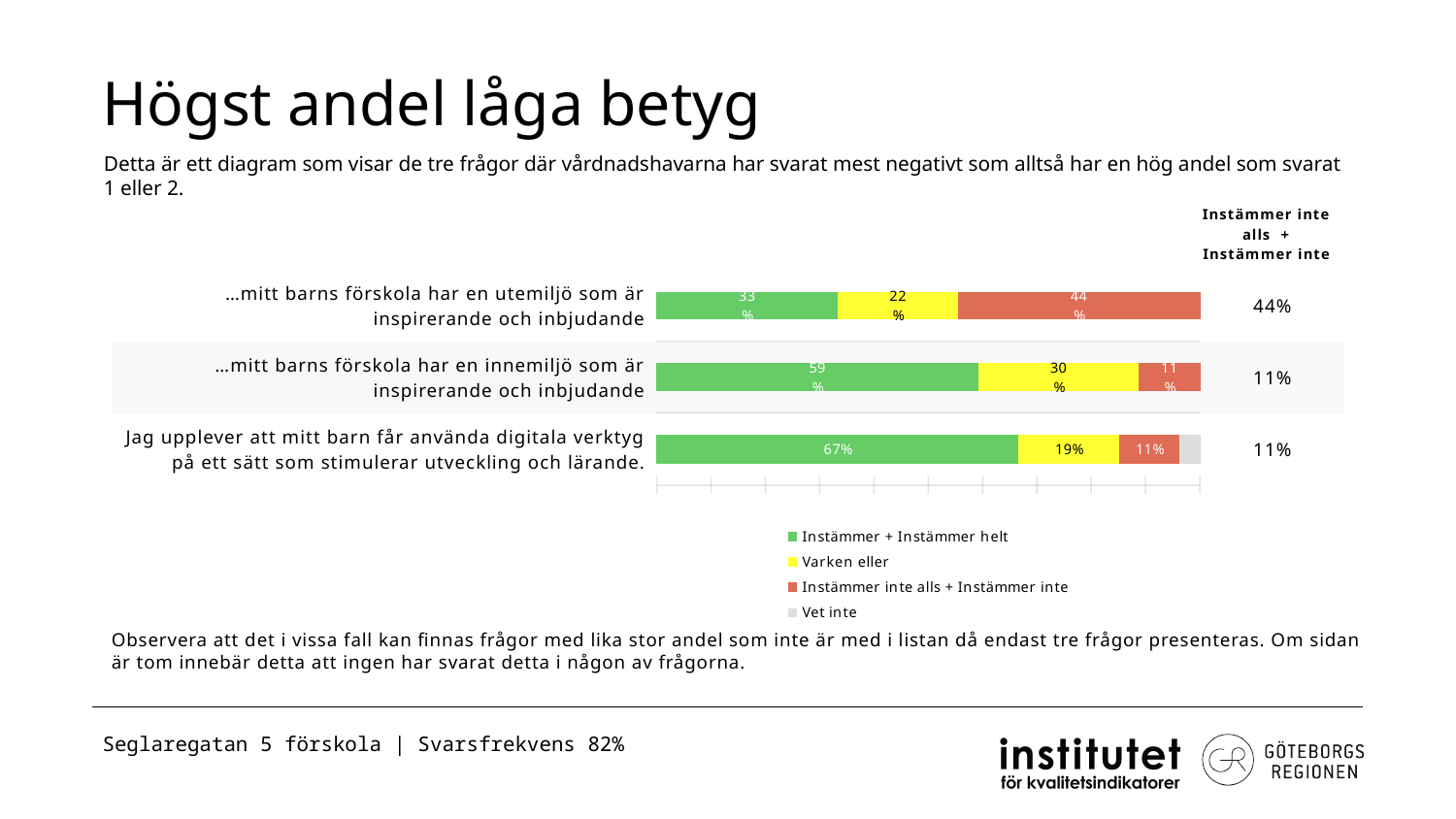
What is the difference between the 'Instämmer + Instämmer helt' values for the digital tools question (67%) and the outdoor environment question (33%)? 34 percentage points What is the 'Instämmer inte alls + Instämmer inte' value for '…mitt barns förskola har en utemiljö som är inspirerande och inbjudande'? 44% How many questions (categories) are plotted in the chart? 3 What is the 'Instämmer + Instämmer helt' value for 'Jag upplever att mitt barn får använda digitala verktyg på ett sätt som stimulerar utveckling och lärande'? 67% Which legend entry is shown in grey? Vet inte What is the 'Varken eller' value for '…mitt barns förskola har en innemiljö som är inspirerande och inbjudande'? 30% What kind of chart is shown on the slide? Stacked bar chart Which question has the highest 'Instämmer inte alls + Instämmer inte' share? …mitt barns förskola har en utemiljö som är inspirerande och inbjudande How many series does the legend list? 4 Which question has the lowest 'Instämmer + Instämmer helt' share? …mitt barns förskola har en utemiljö som är inspirerande och inbjudande What is the 'Instämmer + Instämmer helt' value for '…mitt barns förskola har en utemiljö som är inspirerande och inbjudande'? 33% Which is larger: the 'Varken eller' value for the innemiljö question or for the utemiljö question? Innemiljö question (30%)